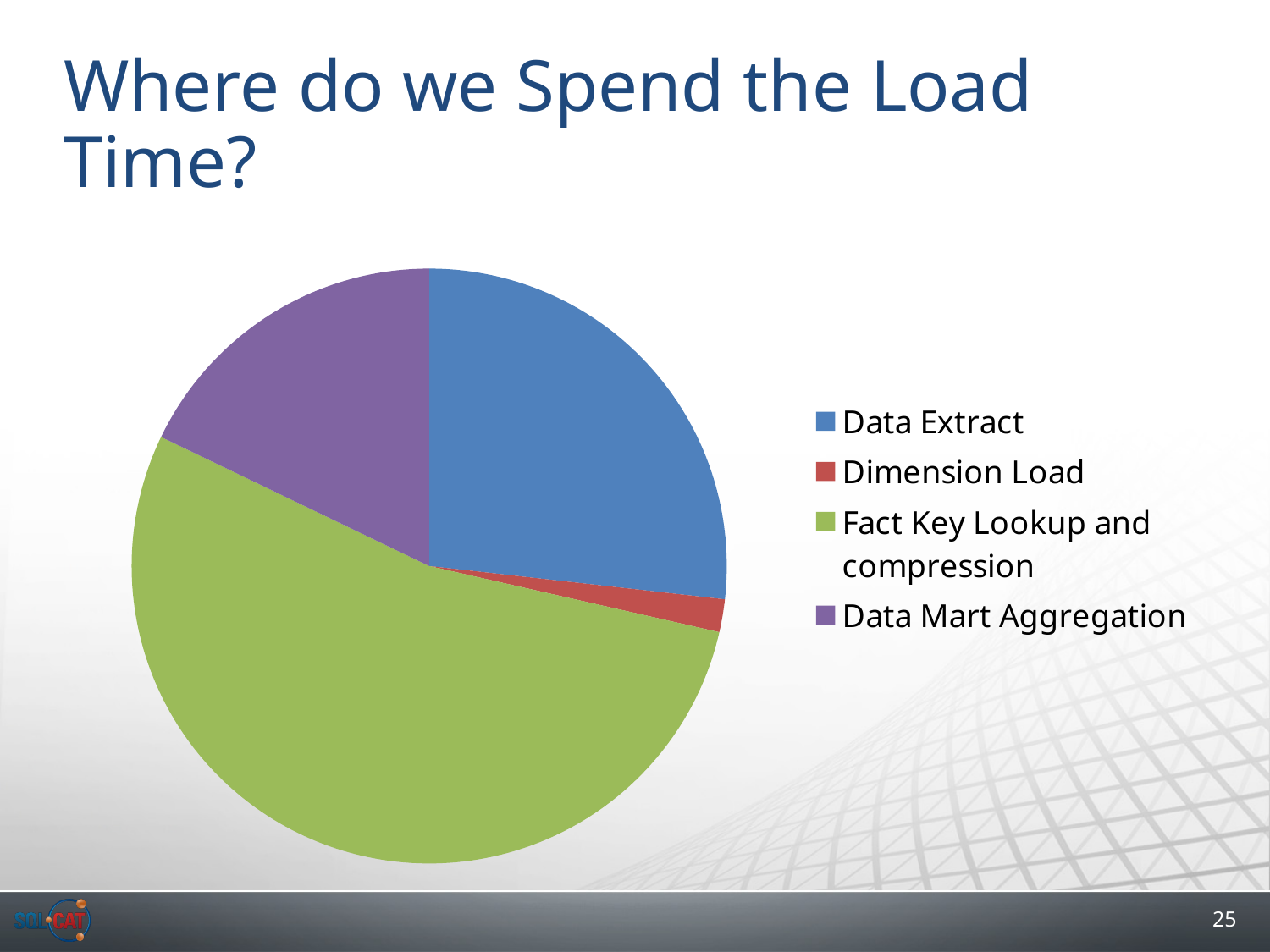
How many entries does the legend list? 4 Which category takes the smallest share of the load time? Dimension Load What colour is the slice for Dimension Load? red Which is larger, the slice for Data Extract or the slice for Data Mart Aggregation? Data Extract What is the title of the slide containing the pie chart? Where do we Spend the Load Time? How many slices does the pie chart have? 4 Which is larger, the slice for Dimension Load or the slice for Data Mart Aggregation? Data Mart Aggregation What kind of chart is shown on the slide? pie chart Does the Fact Key Lookup and compression slice take up more or less than half of the pie? more Which category takes the largest share of the load time? Fact Key Lookup and compression